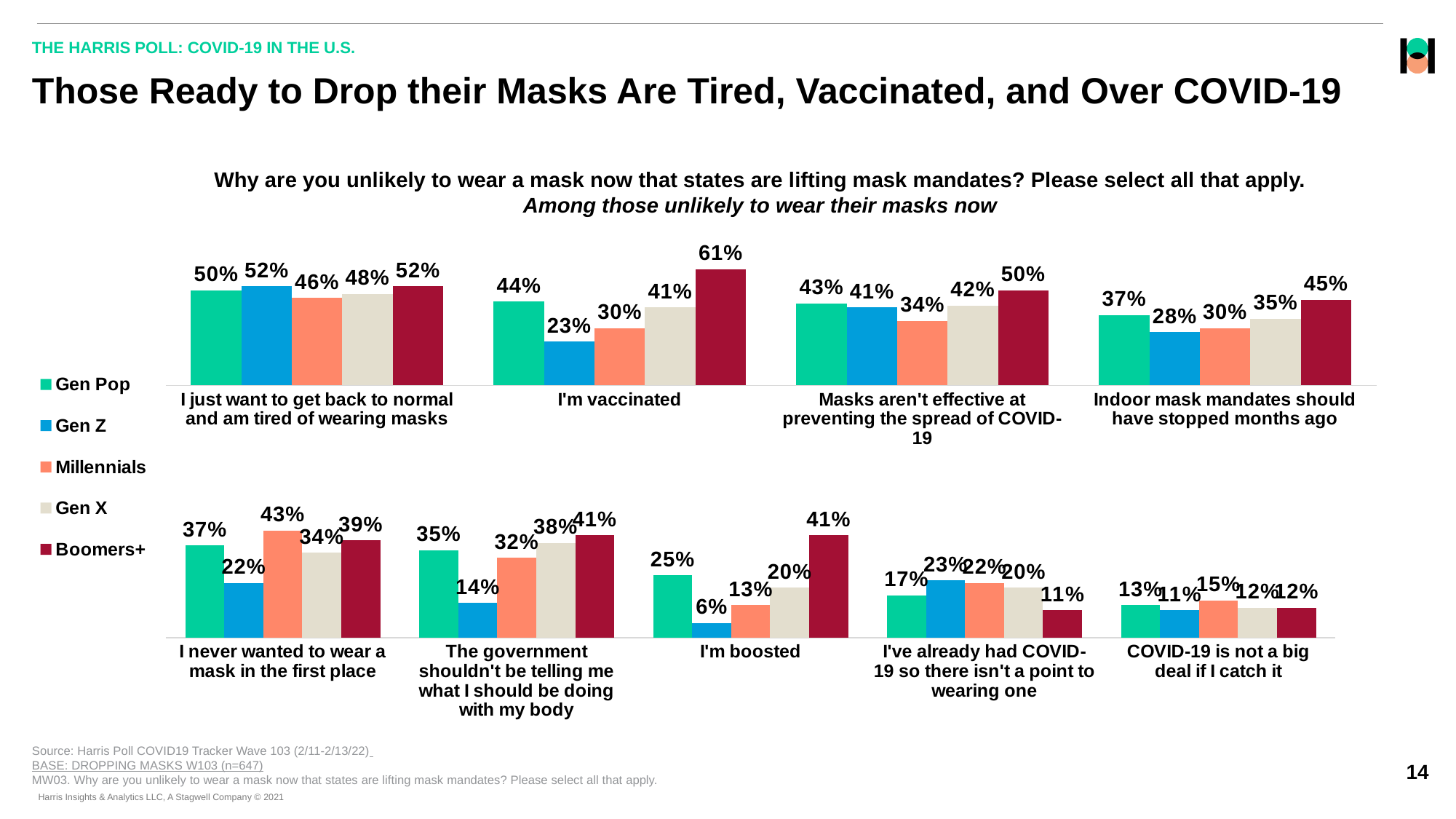
In the top chart, what is the difference between the Boomers+ and Gen Z values for "I'm vaccinated"? 38 percentage points In the top chart, what is the Gen Z value for "Indoor mask mandates should have stopped months ago"? 28% In the bottom chart, what is the Gen Z value for "I'm boosted"? 6% How many categories are shown in the bottom chart? 5 In the bottom chart, which series has the lowest value for "The government shouldn't be telling me what I should be doing with my body"? Gen Z What kind of chart is used on this slide? Bar chart In the bottom chart, what is the Millennials value for "I never wanted to wear a mask in the first place"? 43% In the top chart, what is the Boomers+ value for "I'm vaccinated"? 61% In the bottom chart, which is larger for "I've already had COVID-19 so there isn't a point to wearing one": the Gen Z value or the Boomers+ value? Gen Z In the top chart, which series has the highest value for "I'm vaccinated"? Boomers+ How many series does the legend list? 5 In the bottom chart, what is the difference between the Gen Pop and Gen Z values for "I'm boosted"? 19 percentage points